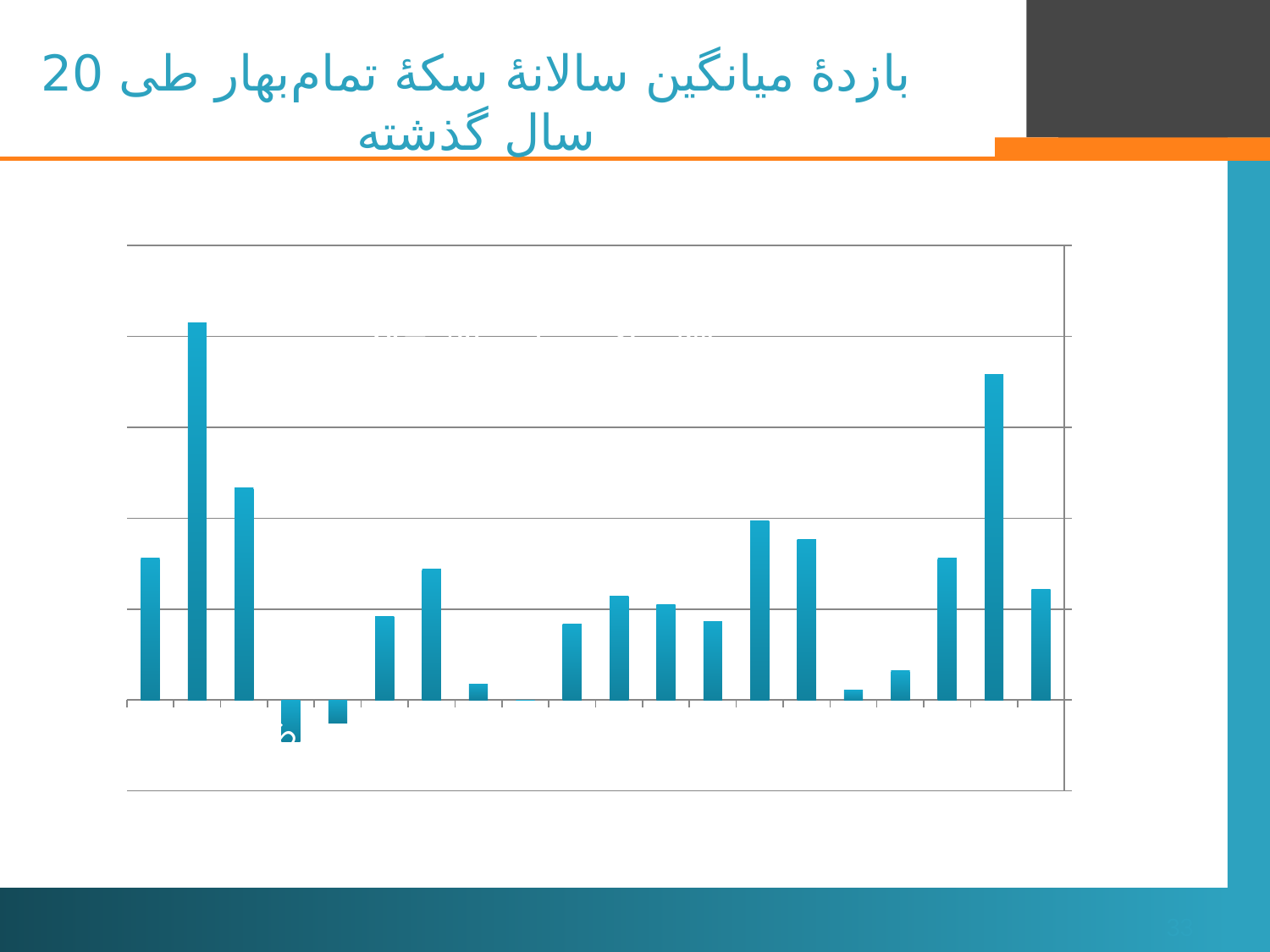
What colour are the bars on the chart? blue Which is taller, the first bar from the left or the last bar on the right? the first bar from the left Which bar is the lowest on the chart? the fourth bar from the left Which bar is the tallest on the chart? the second bar from the left How many bars on the chart extend below the zero line? 2 What kind of chart is shown on the slide? bar chart Which is taller, the second bar from the left or the second bar from the right? the second bar from the left Which is taller, the second bar from the left or the third bar from the left? the second bar from the left According to the slide title, how many years does the chart cover? 20